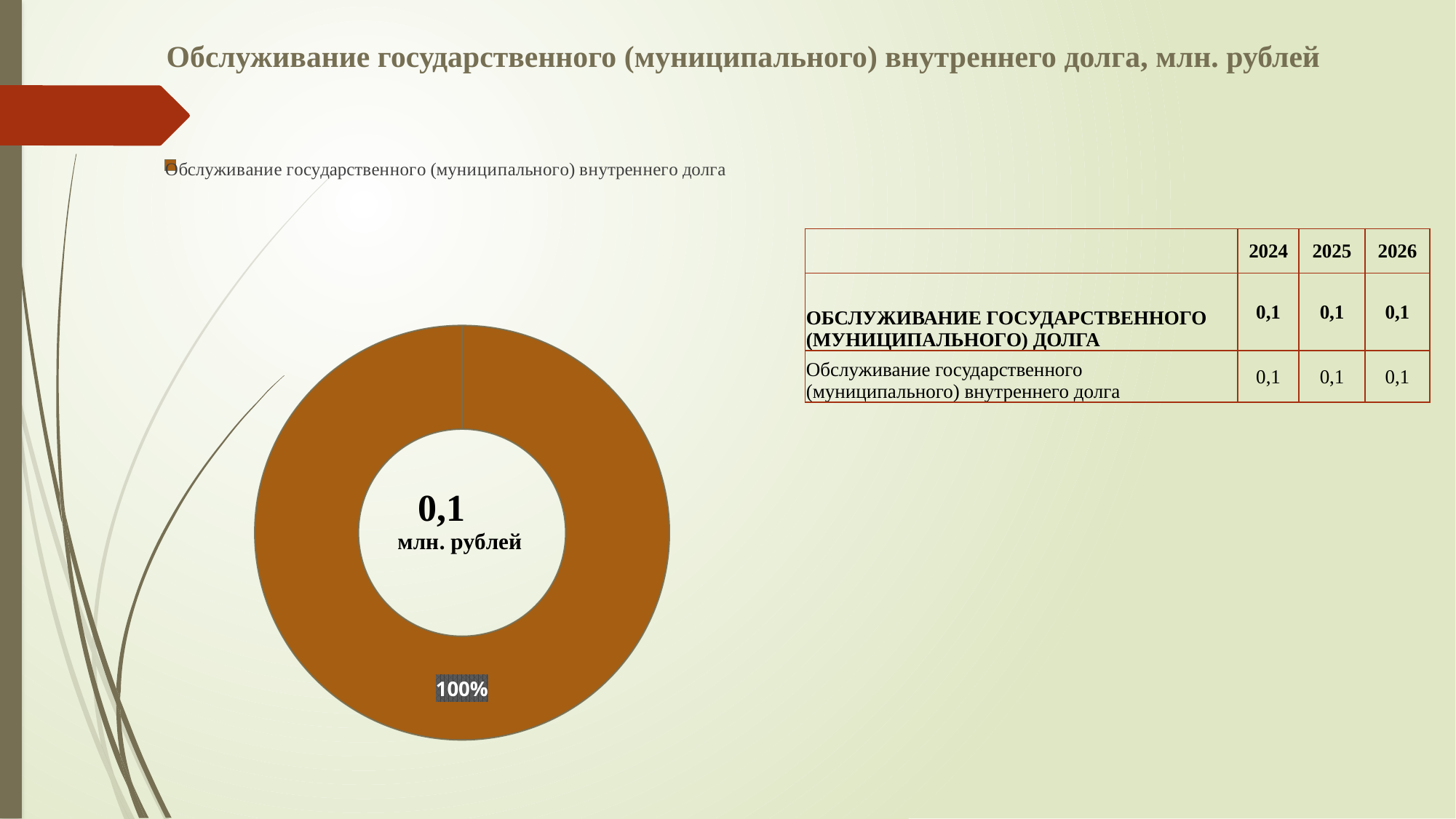
What kind of chart is shown on the slide? doughnut chart What is the title of the chart on the slide? Обслуживание государственного (муниципального) внутреннего долга, млн. рублей What percentage label is printed on the single slice of the doughnut chart? 100% What share of the doughnut chart does the slice "Обслуживание государственного (муниципального) внутреннего долга" take? 100% What is the legend entry of the doughnut chart? Обслуживание государственного (муниципального) внутреннего долга What value is printed in the centre of the doughnut chart? 0,1 млн. рублей How many entries does the chart legend list? 1 How many slices does the doughnut chart have? 1